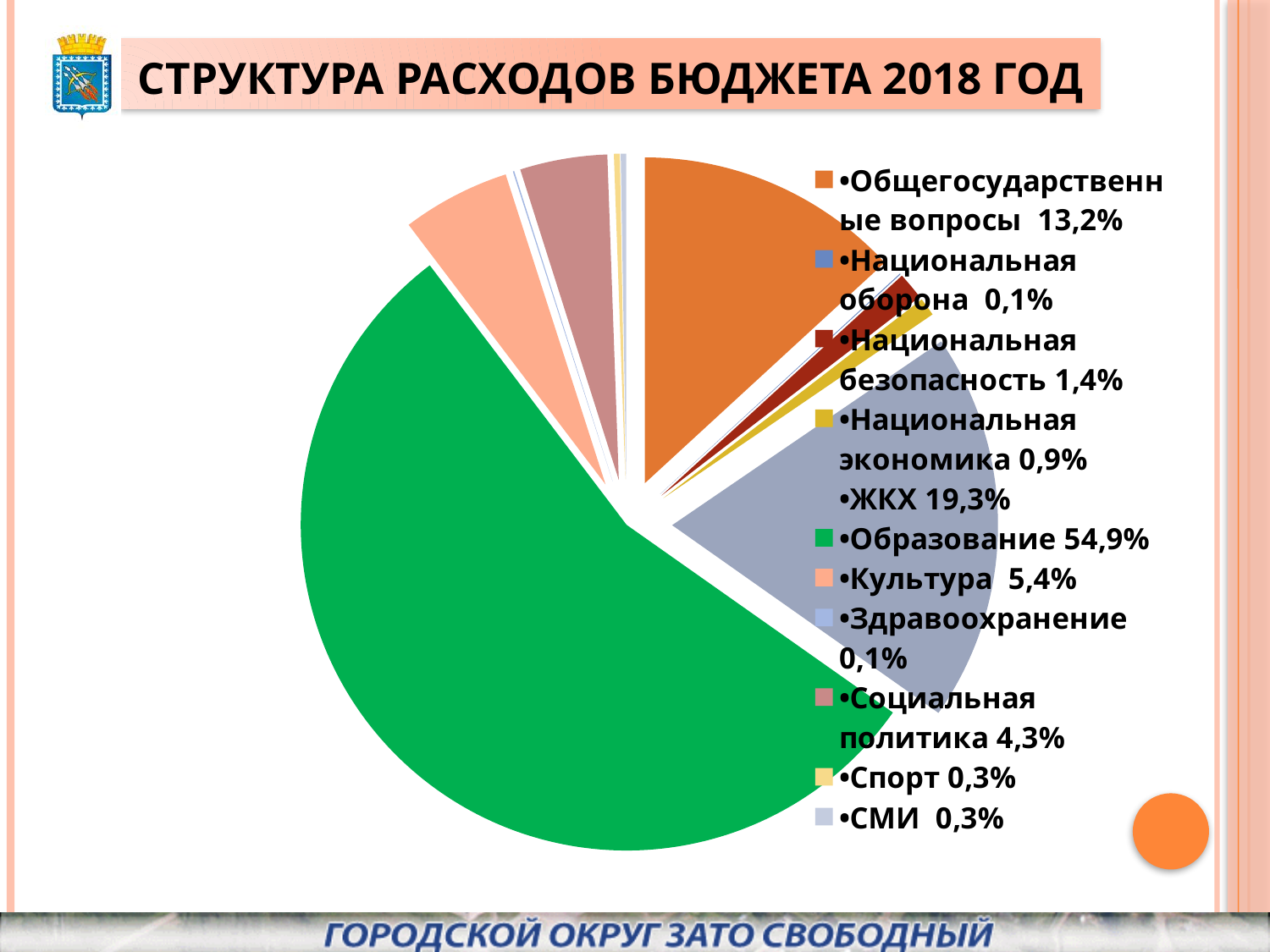
What kind of chart is shown on the slide? pie chart What colour is the slice for Образование? green What share of the budget expenditure goes to Культура? 5,4% How many categories does the legend of the pie chart list? 11 What is the difference between the share for Образование and the share for ЖКХ? 35,6% What share of the budget expenditure goes to Социальная политика? 4,3% What share of the budget expenditure goes to ЖКХ? 19,3% What is the title of the chart on the slide? СТРУКТУРА РАСХОДОВ БЮДЖЕТА 2018 ГОД What share of the budget expenditure goes to Образование? 54,9% Which category has the largest share of the budget expenditure? Образование What share of the budget expenditure goes to Общегосударственные вопросы? 13,2% Which is larger, the share for ЖКХ or the share for Общегосударственные вопросы? ЖКХ